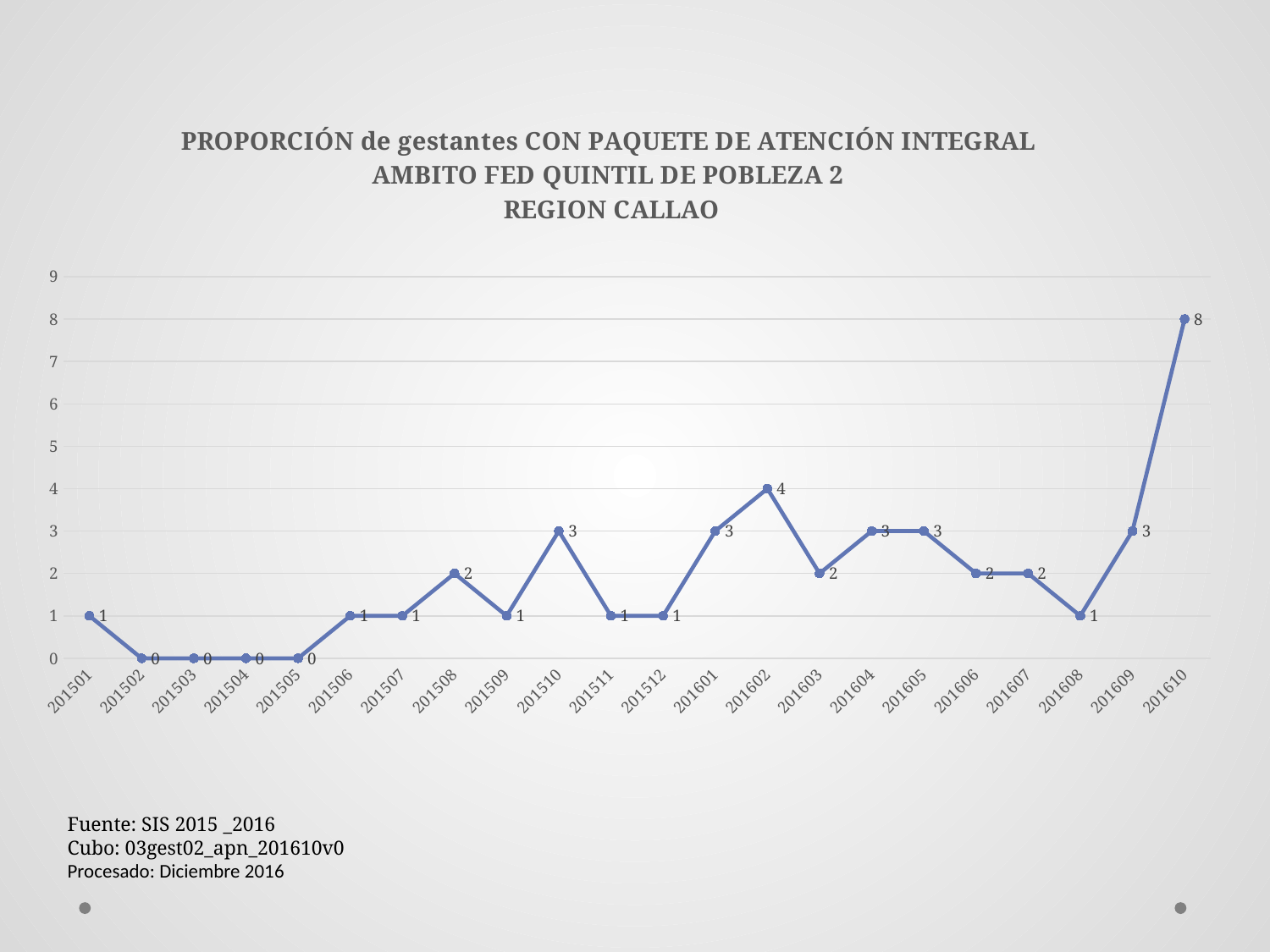
What is the value for 201603? 2 What is the difference between the values for 201602 and 201603? 2 What is the value for 201610? 8 How many periods are plotted on the x axis? 22 What is the difference between the values for 201610 and 201609? 5 Which is larger, the value for 201510 or the value for 201511? 201510 Is the value for 201610 greater or less than 5? greater Which region does the chart title refer to? REGION CALLAO What is the value for 201602? 4 What kind of chart is shown? line chart What is the value for 201508? 2 Which period has the highest value? 201610